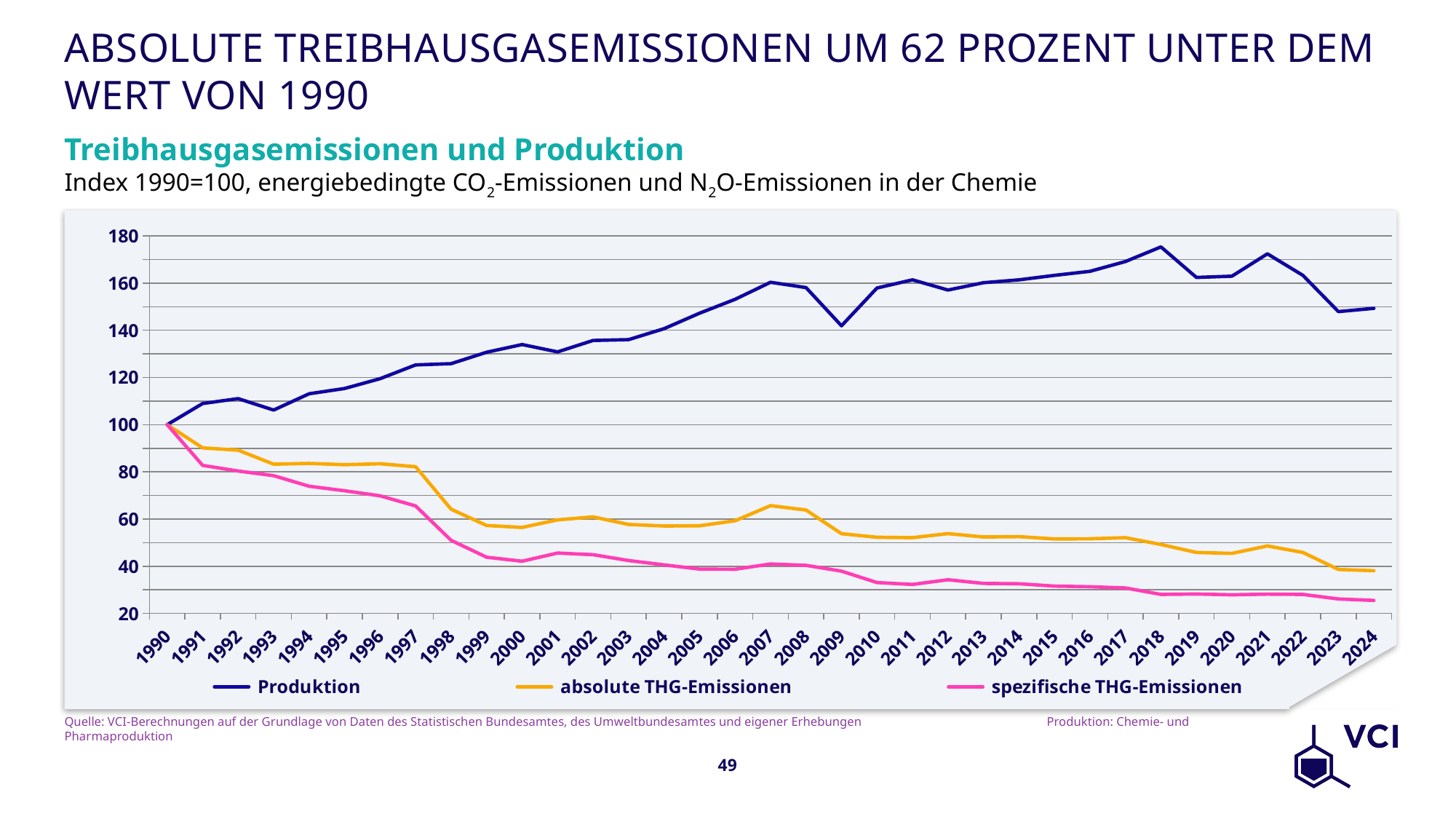
What kind of chart is shown on the slide? line chart In 2024, which is larger: Produktion or absolute THG-Emissionen? Produktion How many series does the legend list? 3 Does the absolute THG-Emissionen line generally rise or fall from 1990 to 2024? fall What is the title of the chart? Treibhausgasemissionen und Produktion In which year does Produktion reach its highest value? 2018 How many years are plotted along the x axis? 35 Is the value for spezifische THG-Emissionen in 2024 greater or less than 40? less What is the value of Produktion in 1990? 100 Is the value for absolute THG-Emissionen in 2007 greater or less than 60? greater Is the value for absolute THG-Emissionen in 2024 greater or less than 40? less